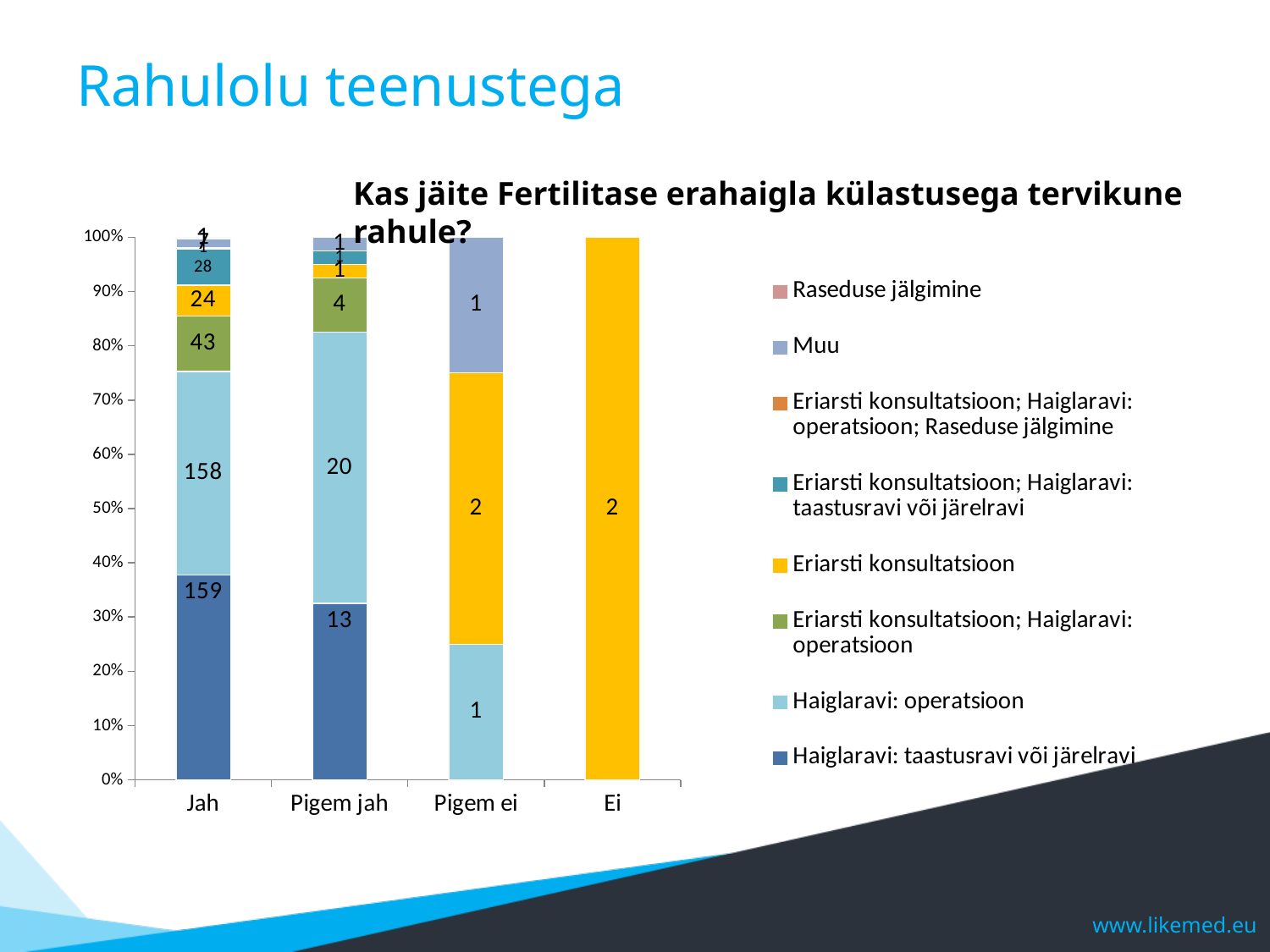
What is the difference between the 'Haiglaravi: operatsioon' values for 'Jah' and 'Pigem jah'? 138 What is the value for 'Haiglaravi: operatsioon' in the 'Pigem jah' category? 20 What kind of chart is shown on the slide? Stacked bar chart What is the title of the chart? Kas jäite Fertilitase erahaigla külastusega tervikune rahule? What is the value for 'Eriarsti konsultatsioon' in the 'Jah' category? 24 What is the value for 'Eriarsti konsultatsioon' in the 'Ei' category? 2 Which is larger in the 'Jah' category: 'Eriarsti konsultatsioon; Haiglaravi: operatsioon' or 'Eriarsti konsultatsioon'? Eriarsti konsultatsioon; Haiglaravi: operatsioon How many series does the chart legend list? 8 What is the value for 'Haiglaravi: operatsioon' in the 'Jah' category? 158 What is the value for 'Eriarsti konsultatsioon; Haiglaravi: operatsioon' in the 'Jah' category? 43 How many categories are shown on the x axis of the chart? 4 What is the value for 'Haiglaravi: taastusravi või järelravi' in the 'Jah' category? 159